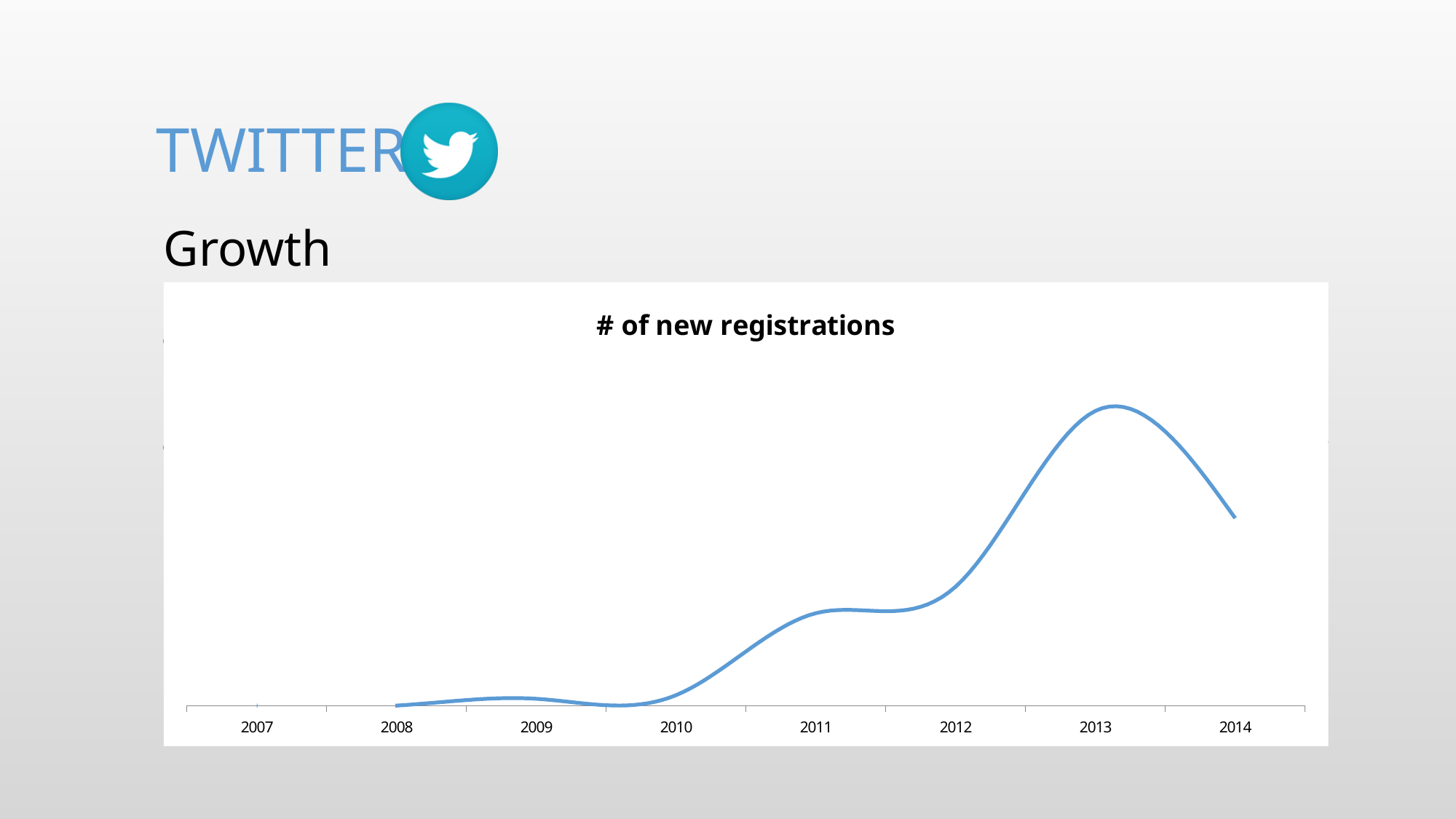
Does the number of new registrations rise or fall from 2010 to 2013? rise How many year labels are shown on the x axis? 8 Which year has more new registrations, 2009 or 2012? 2012 Which year has more new registrations, 2010 or 2011? 2011 Does the number of new registrations rise or fall from 2013 to 2014? fall What kind of chart is shown on the slide? line chart Which year has more new registrations, 2011 or 2012? 2012 In which year does the number of new registrations reach its highest point? 2013 What is the title of the chart? # of new registrations What is the first year label on the x axis? 2007